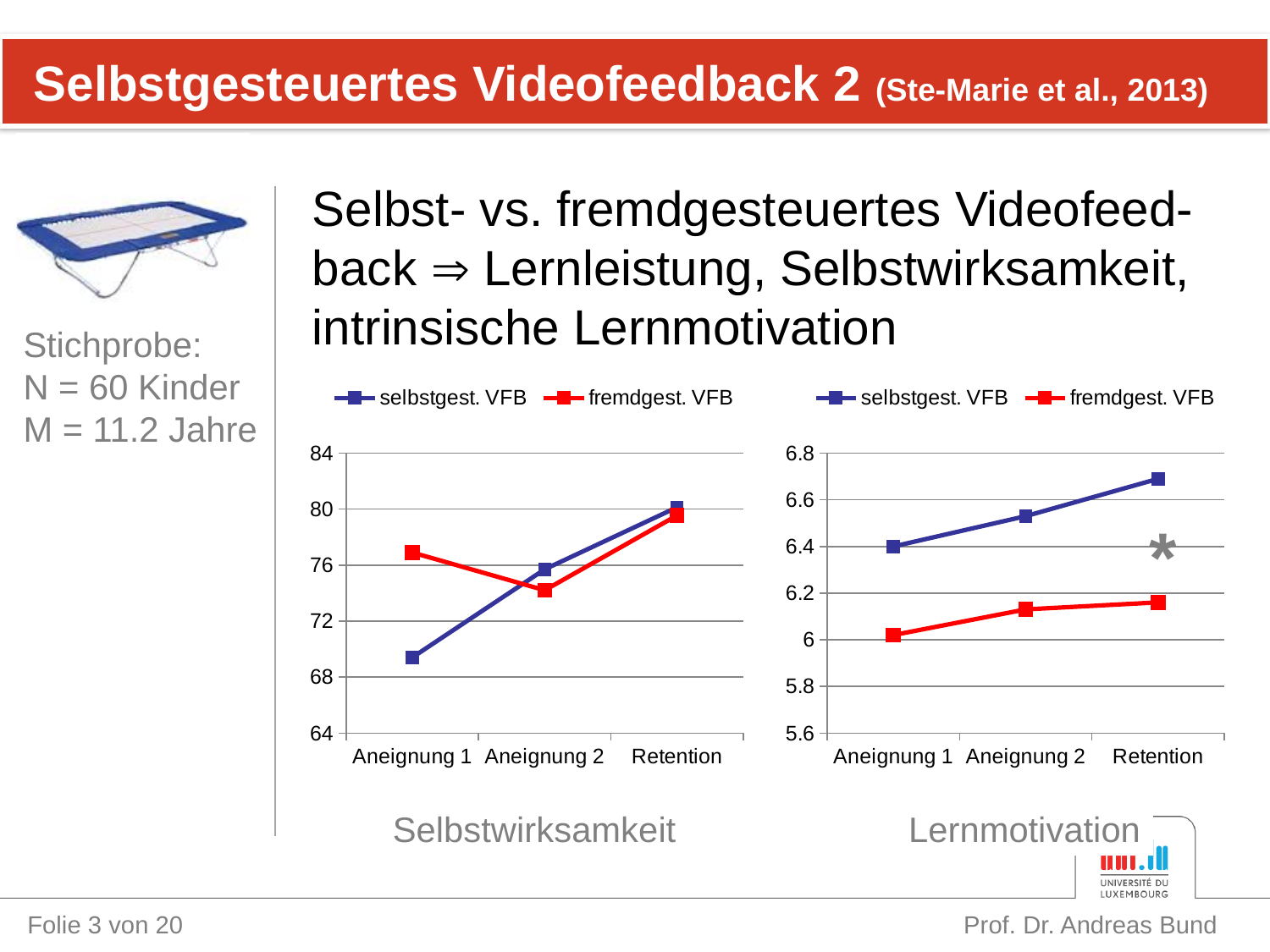
How many categories are shown on the x axis of the Selbstwirksamkeit chart? 3 In the Lernmotivation chart, is the value for fremdgest. VFB at Aneignung 1 greater or less than 6.2? less In the Lernmotivation chart, do the values for selbstgest. VFB rise or fall from Aneignung 1 to Retention? rise In the Selbstwirksamkeit chart, at which category is the selbstgest. VFB value lowest? Aneignung 1 How many series does the legend of the Lernmotivation chart list? 2 In the Selbstwirksamkeit chart, is the value for selbstgest. VFB at Aneignung 1 greater or less than 72? less In the Lernmotivation chart, is the value for selbstgest. VFB at Retention greater or less than 6.6? greater What are the two legend entries of the Selbstwirksamkeit chart? selbstgest. VFB and fremdgest. VFB What kind of chart is the Selbstwirksamkeit chart on the left? line chart In the Selbstwirksamkeit chart, which series has the higher value at Aneignung 1? fremdgest. VFB In the Lernmotivation chart, which series has the higher value at Retention? selbstgest. VFB